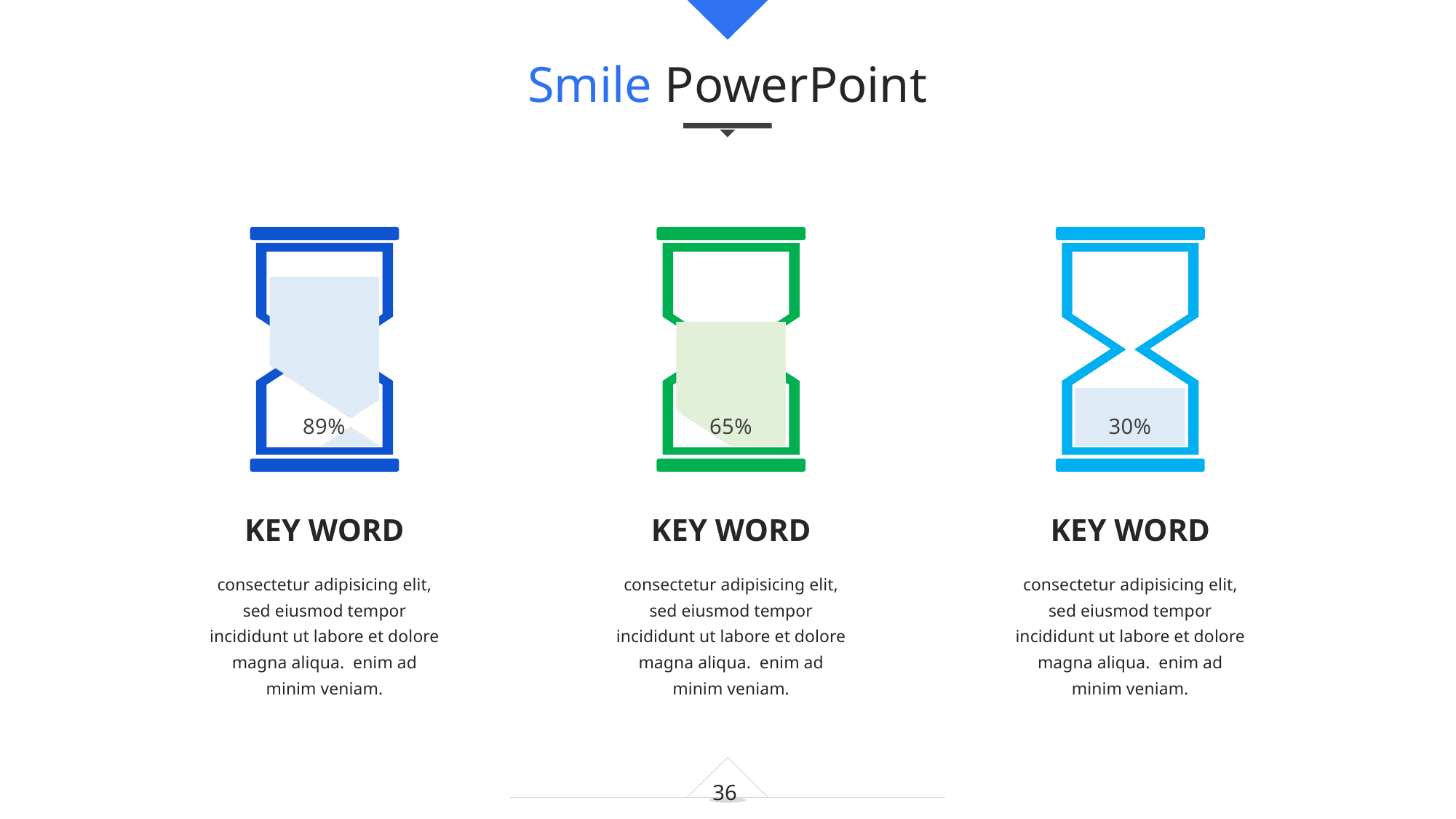
Which hourglass shows the lowest percentage: left, middle or right? right What is the difference between the percentages in the middle and right hourglasses? 35% What is the difference between the percentages in the left and right hourglasses? 59% How many hourglass figures with percentages are shown on the slide? 3 Which is larger, the percentage in the middle hourglass or the percentage in the right hourglass? middle hourglass What percentage is shown in the left (dark blue) hourglass? 89% What is the difference between the percentages in the left and middle hourglasses? 24% Which hourglass shows the highest percentage: left, middle or right? left What is the title of the slide? Smile PowerPoint What percentage is shown in the right (light blue) hourglass? 30% What colour is the hourglass that shows 65%? green What percentage is shown in the middle (green) hourglass? 65%